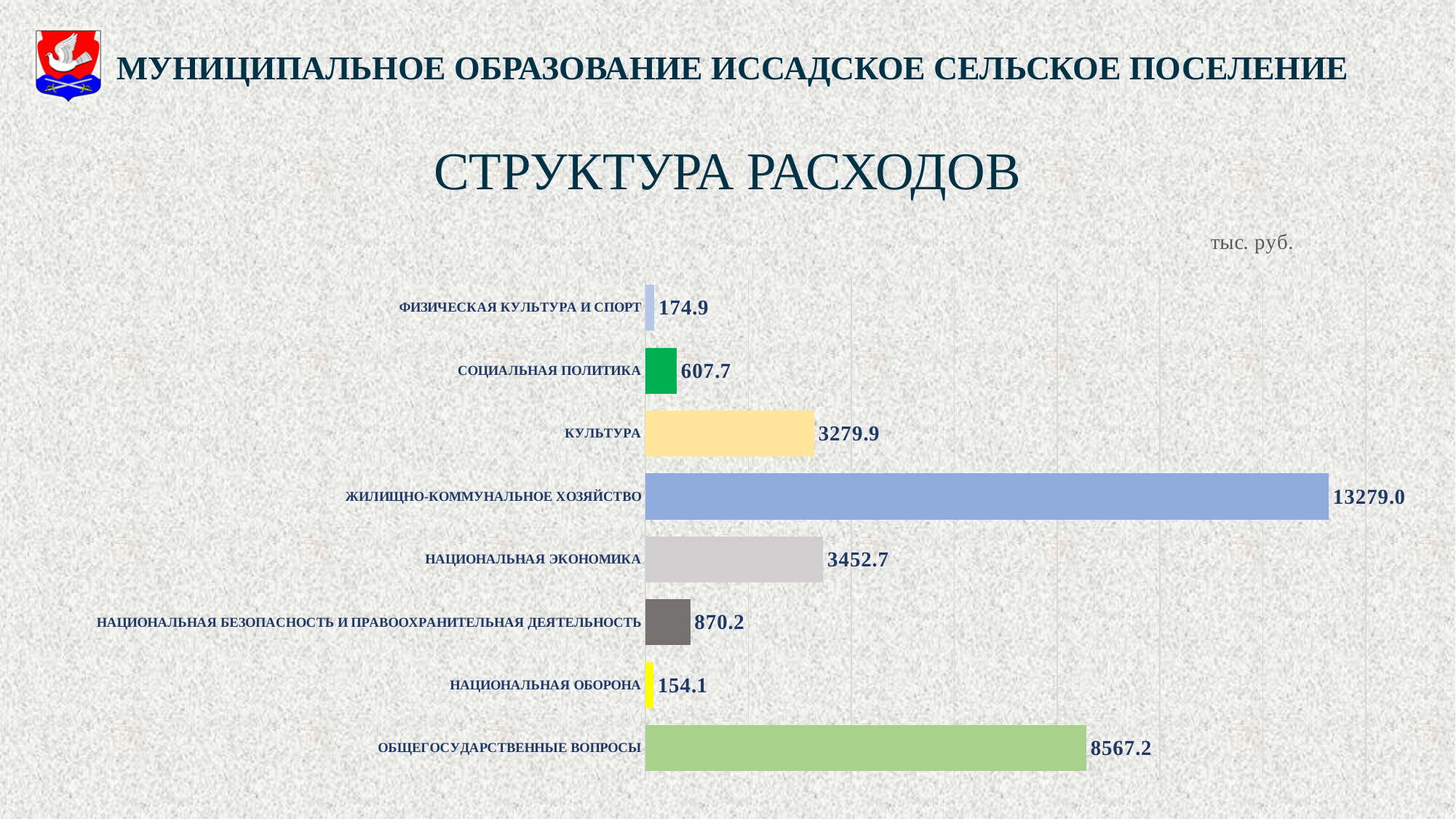
What kind of chart is shown on the slide? Bar chart What is the difference between the values for НАЦИОНАЛЬНАЯ ЭКОНОМИКА and КУЛЬТУРА? 172.8 Which category has the highest value? ЖИЛИЩНО-КОММУНАЛЬНОЕ ХОЗЯЙСТВО What is the difference between the values for ЖИЛИЩНО-КОММУНАЛЬНОЕ ХОЗЯЙСТВО and ОБЩЕГОСУДАРСТВЕННЫЕ ВОПРОСЫ? 4711.8 What is the value for НАЦИОНАЛЬНАЯ ОБОРОНА? 154.1 Which category has the lowest value? НАЦИОНАЛЬНАЯ ОБОРОНА What is the value for ЖИЛИЩНО-КОММУНАЛЬНОЕ ХОЗЯЙСТВО? 13279.0 What is the value for СОЦИАЛЬНАЯ ПОЛИТИКА? 607.7 What is the value for ОБЩЕГОСУДАРСТВЕННЫЕ ВОПРОСЫ? 8567.2 How many categories are shown in the chart? 8 Which is larger, the value for НАЦИОНАЛЬНАЯ БЕЗОПАСНОСТЬ И ПРАВООХРАНИТЕЛЬНАЯ ДЕЯТЕЛЬНОСТЬ or the value for СОЦИАЛЬНАЯ ПОЛИТИКА? НАЦИОНАЛЬНАЯ БЕЗОПАСНОСТЬ И ПРАВООХРАНИТЕЛЬНАЯ ДЕЯТЕЛЬНОСТЬ What unit is indicated for the values in the chart? тыс. руб.